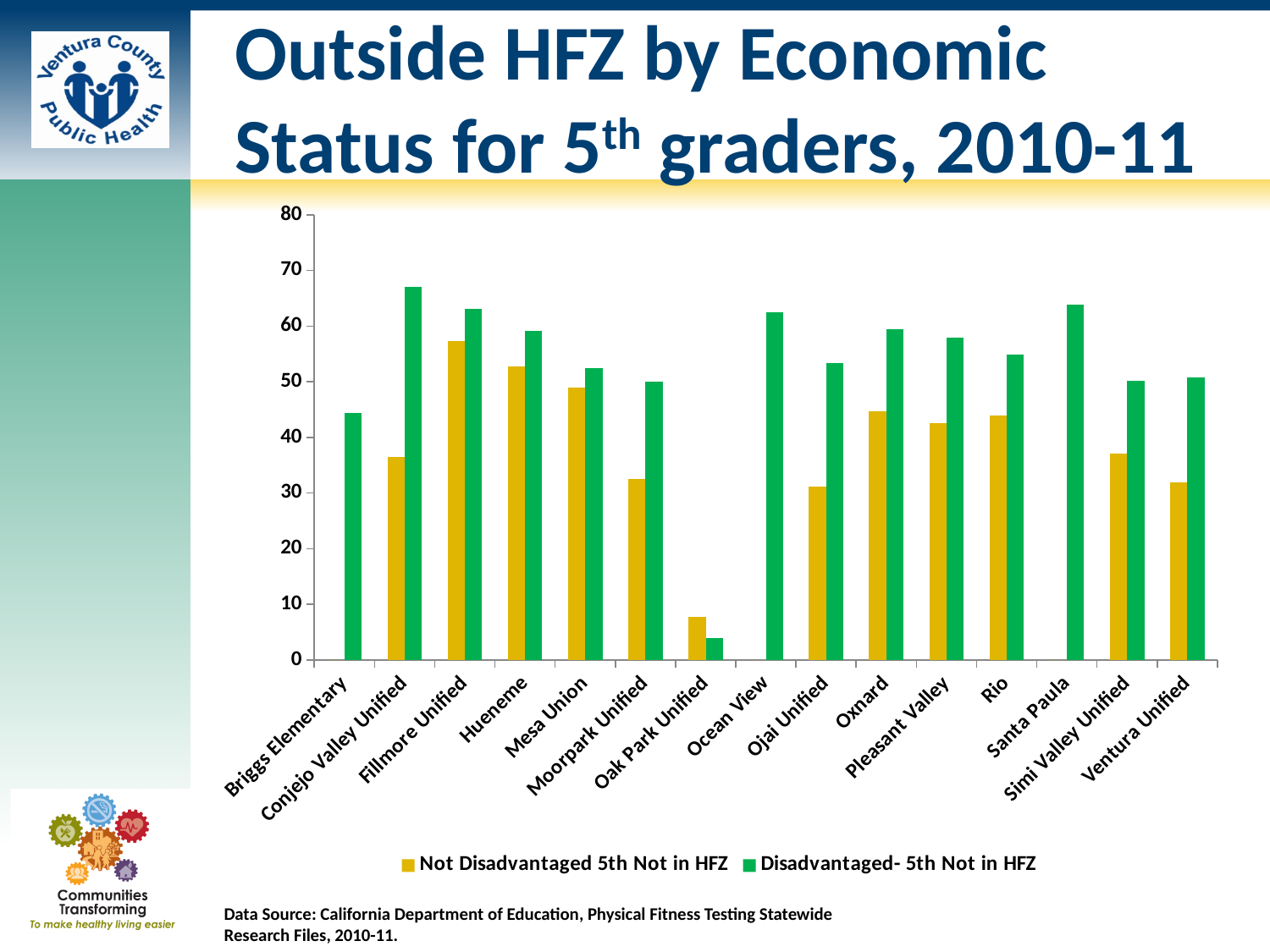
Is the Not Disadvantaged 5th Not in HFZ value for Ventura Unified greater or less than 40? less Is the Disadvantaged- 5th Not in HFZ value for Conejo Valley Unified greater or less than 60? greater Which district has the highest value for Not Disadvantaged 5th Not in HFZ? Fillmore Unified For Oak Park Unified, which series has the larger value: Not Disadvantaged 5th Not in HFZ or Disadvantaged- 5th Not in HFZ? Not Disadvantaged 5th Not in HFZ Is the Disadvantaged- 5th Not in HFZ value for Oak Park Unified greater or less than 10? less How many school districts are shown on the x axis? 15 Which district has the lowest value for Disadvantaged- 5th Not in HFZ? Oak Park Unified How many series does the legend list? 2 What kind of chart is shown on the slide? bar chart Which district has the highest value for Disadvantaged- 5th Not in HFZ? Conjejo Valley Unified Which colour represents the Disadvantaged- 5th Not in HFZ series? green